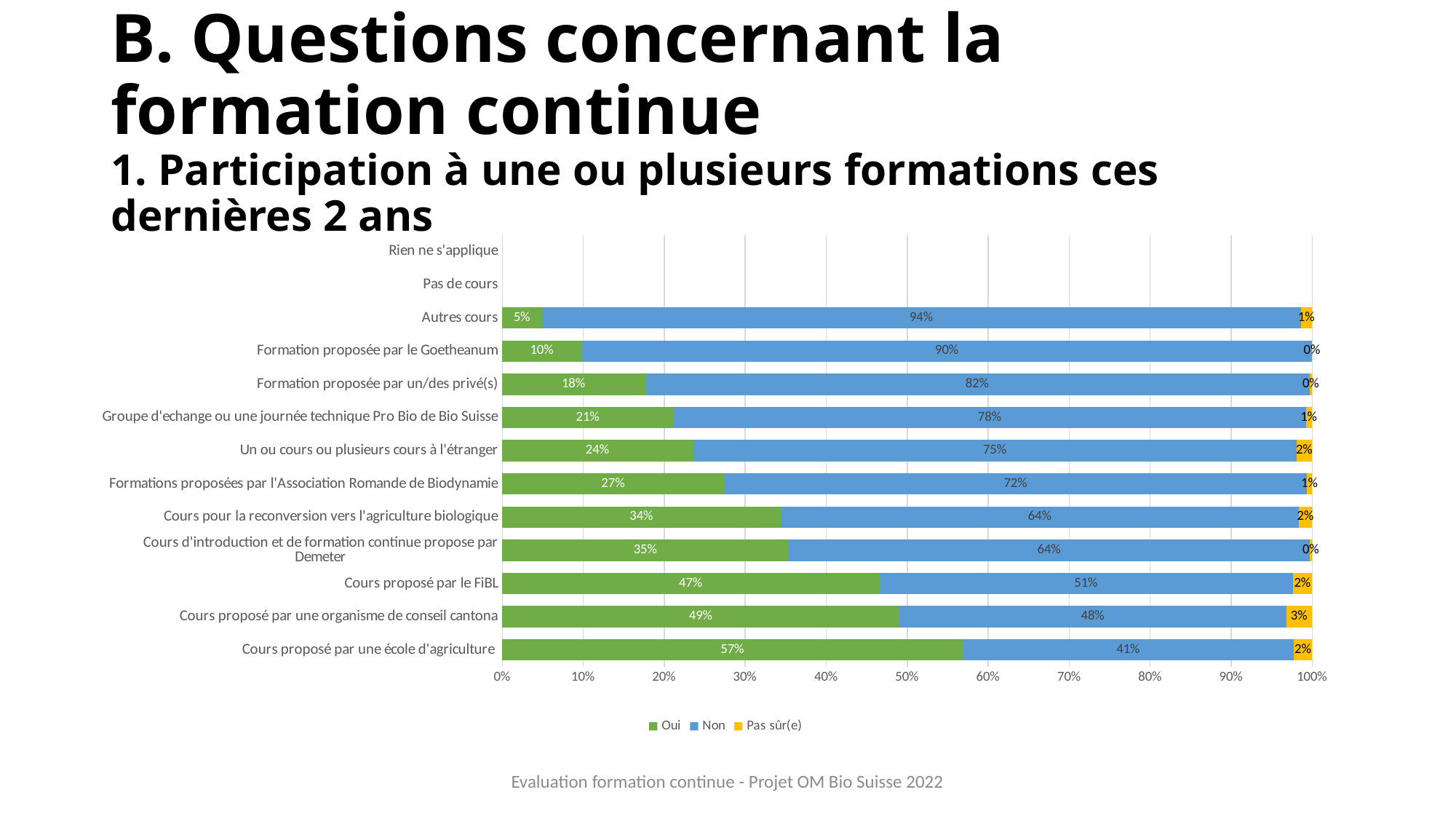
What is the total of the stacked bar for 'Cours proposé par une école d'agriculture'? 100% What is the 'Oui' value for 'Cours proposé par une école d'agriculture'? 57% Among the categories with plotted bars, which has the lowest 'Oui' value? Autres cours What is the difference in percentage points between the 'Oui' value for 'Cours proposé par une école d'agriculture' and the 'Oui' value for 'Cours proposé par le FiBL'? 10 Which has a larger 'Oui' value: 'Cours proposé par le FiBL' or 'Cours d'introduction et de formation continue propose par Demeter'? Cours proposé par le FiBL How many categories are listed on the vertical axis of the chart? 13 What is the 'Non' value for 'Autres cours'? 94% Which category has the highest 'Oui' value? Cours proposé par une école d'agriculture What kind of chart is shown on the slide? Stacked bar chart Which colour represents the 'Oui' series in the legend? Green What is the 'Pas sûr(e)' value for 'Cours proposé par une organisme de conseil cantona'? 3% How many series does the legend list? 3